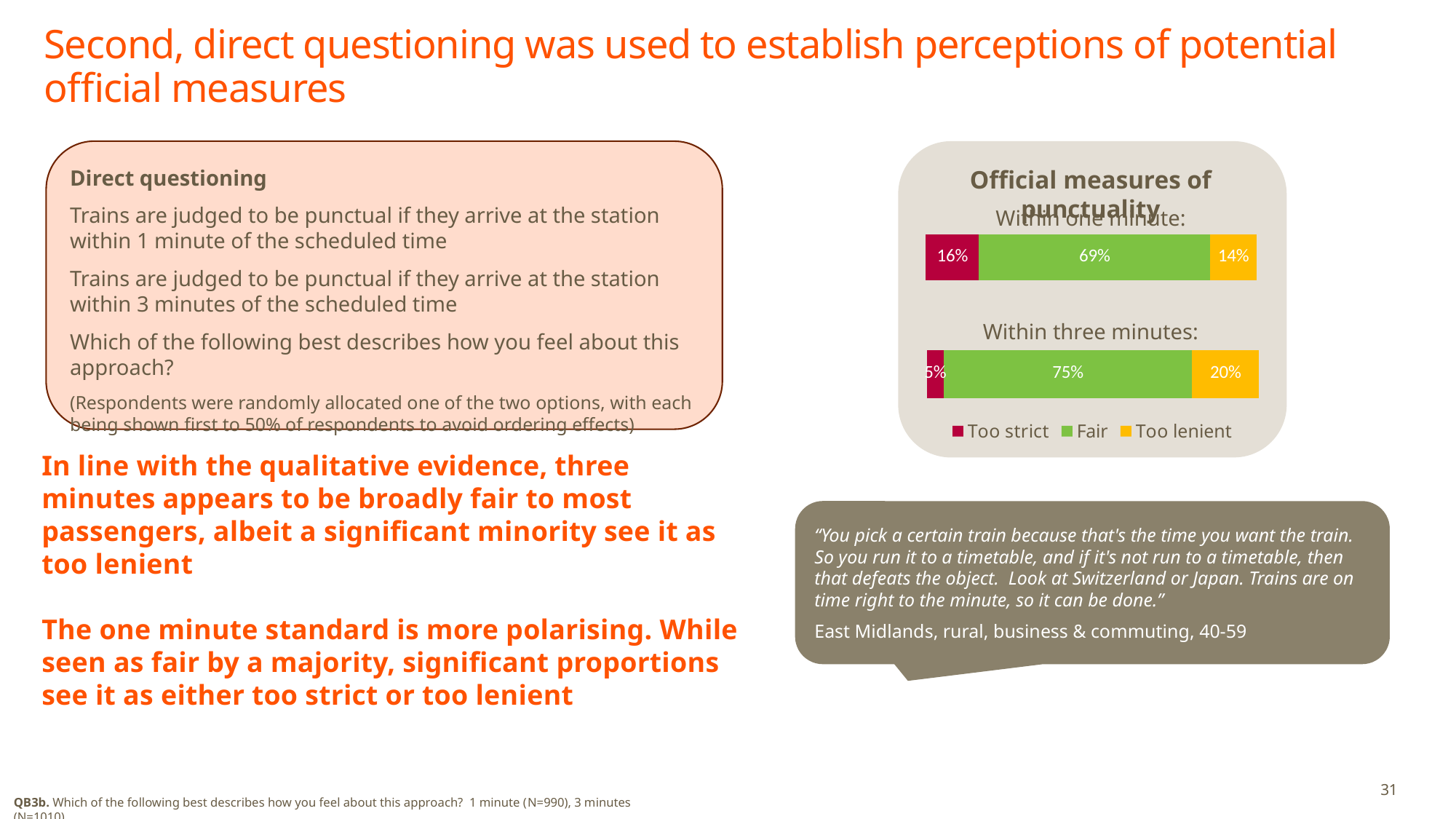
Which response category has the smallest share for the 'Within one minute' bar? Too lenient Which colour represents 'Too strict' in the chart? Dark red How many series does the chart legend list? 3 Which is larger: the 'Too lenient' share for one minute or for three minutes? Three minutes What percentage of respondents said the one-minute standard is too lenient? 14% What percentage of respondents said the one-minute standard is fair? 69% What type of chart is used to show the official measures of punctuality? Stacked bar chart What percentage of respondents said the one-minute standard is too strict? 16% What is the difference between the 'Fair' share for three minutes and the 'Fair' share for one minute? 6 percentage points What percentage of respondents said the three-minute standard is too lenient? 20% Which response category has the largest share for the 'Within three minutes' bar? Fair What percentage of respondents said the three-minute standard is fair? 75%